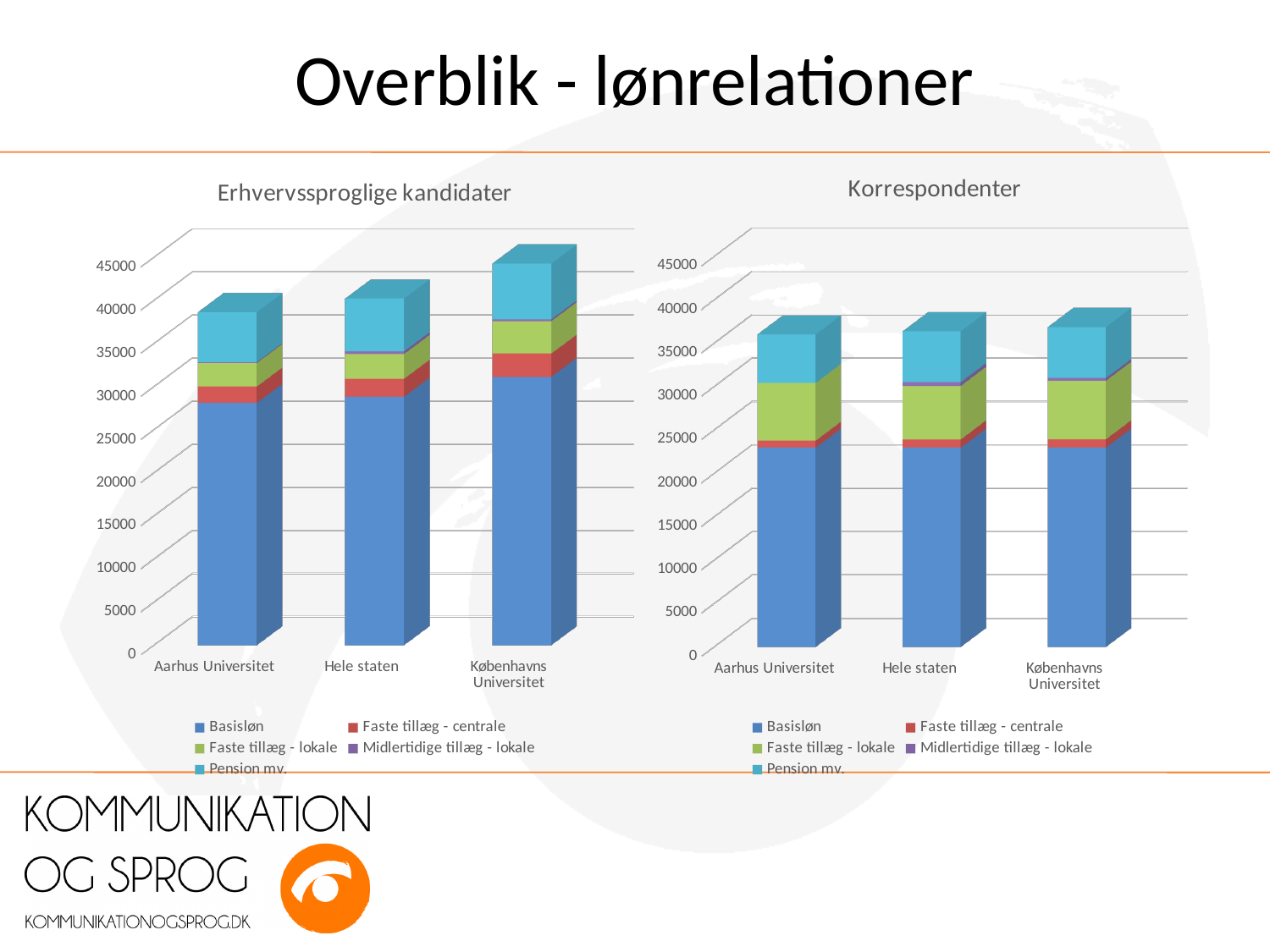
Which series is shown in light blue at the top of the stacked bars in the 'Korrespondenter' chart? Pension mv. In the 'Korrespondenter' chart, is the Basisløn value for Hele staten greater or less than 25000? less How many series does the legend of the 'Erhvervssproglige kandidater' chart list? 5 Which chart is on the right side of the slide? Korrespondenter How many categories are shown on the x axis of the 'Korrespondenter' chart? 3 In the 'Erhvervssproglige kandidater' chart, is the total for Københavns Universitet larger or smaller than the total for Aarhus Universitet? larger In the 'Korrespondenter' chart, is the total for Københavns Universitet greater or less than 35000? greater In the 'Erhvervssproglige kandidater' chart, is the Basisløn value for Aarhus Universitet greater or less than 30000? less What kind of chart is the 'Erhvervssproglige kandidater' chart? Stacked bar chart In the 'Erhvervssproglige kandidater' chart, which category has the highest total bar? Københavns Universitet